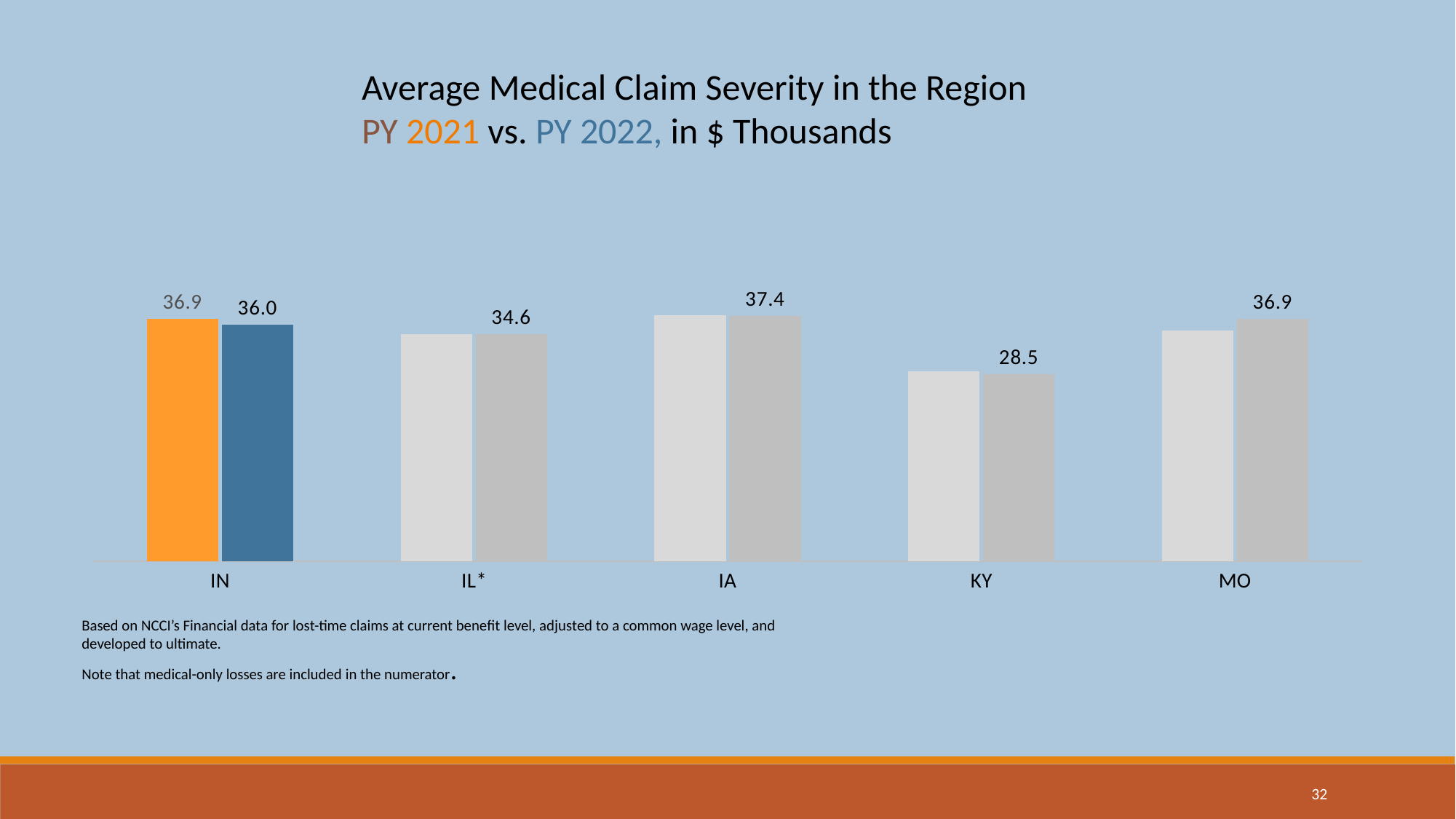
What is the PY 2022 value shown for KY? 28.5 What type of chart is shown on the slide? Bar chart Which state has the lowest PY 2022 average medical claim severity? KY Which state has the larger PY 2022 value, IA or MO? IA What is the PY 2021 average medical claim severity for IN? 36.9 What is the PY 2022 value shown for IA? 37.4 What is the PY 2022 value shown for MO? 36.9 By how much did IN's average medical claim severity change from PY 2021 to PY 2022? 0.9 What is the PY 2022 value shown for IL*? 34.6 How many states are shown on the chart? 5 Which state has the highest PY 2022 average medical claim severity? IA What is the PY 2022 average medical claim severity for IN? 36.0